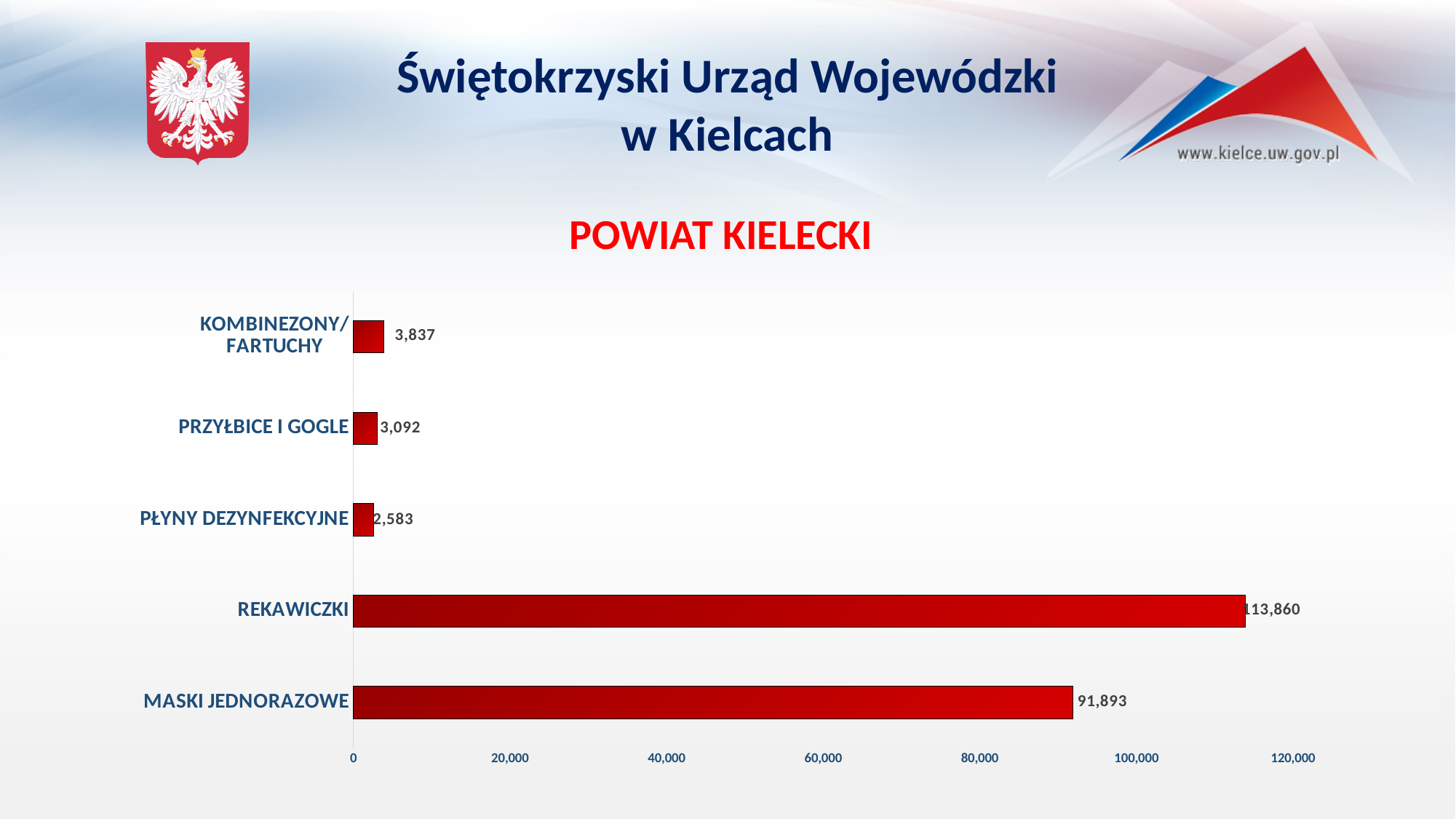
How many categories are shown in the chart? 5 What is the value for MASKI JEDNORAZOWE? 91,893 Which category has the lowest value? PŁYNY DEZYNFEKCYJNE What is the value for KOMBINEZONY/FARTUCHY? 3,837 What is the value for PŁYNY DEZYNFEKCYJNE? 2,583 Which is larger, the value for PRZYŁBICE I GOGLE or the value for PŁYNY DEZYNFEKCYJNE? PRZYŁBICE I GOGLE What kind of chart is shown on the slide? bar chart What is the difference between the values for KOMBINEZONY/FARTUCHY and PRZYŁBICE I GOGLE? 745 Which category has the highest value? REKAWICZKI What is the difference between the values for REKAWICZKI and MASKI JEDNORAZOWE? 21,967 Is the value for MASKI JEDNORAZOWE greater or less than 100,000? less What is the value for REKAWICZKI? 113,860